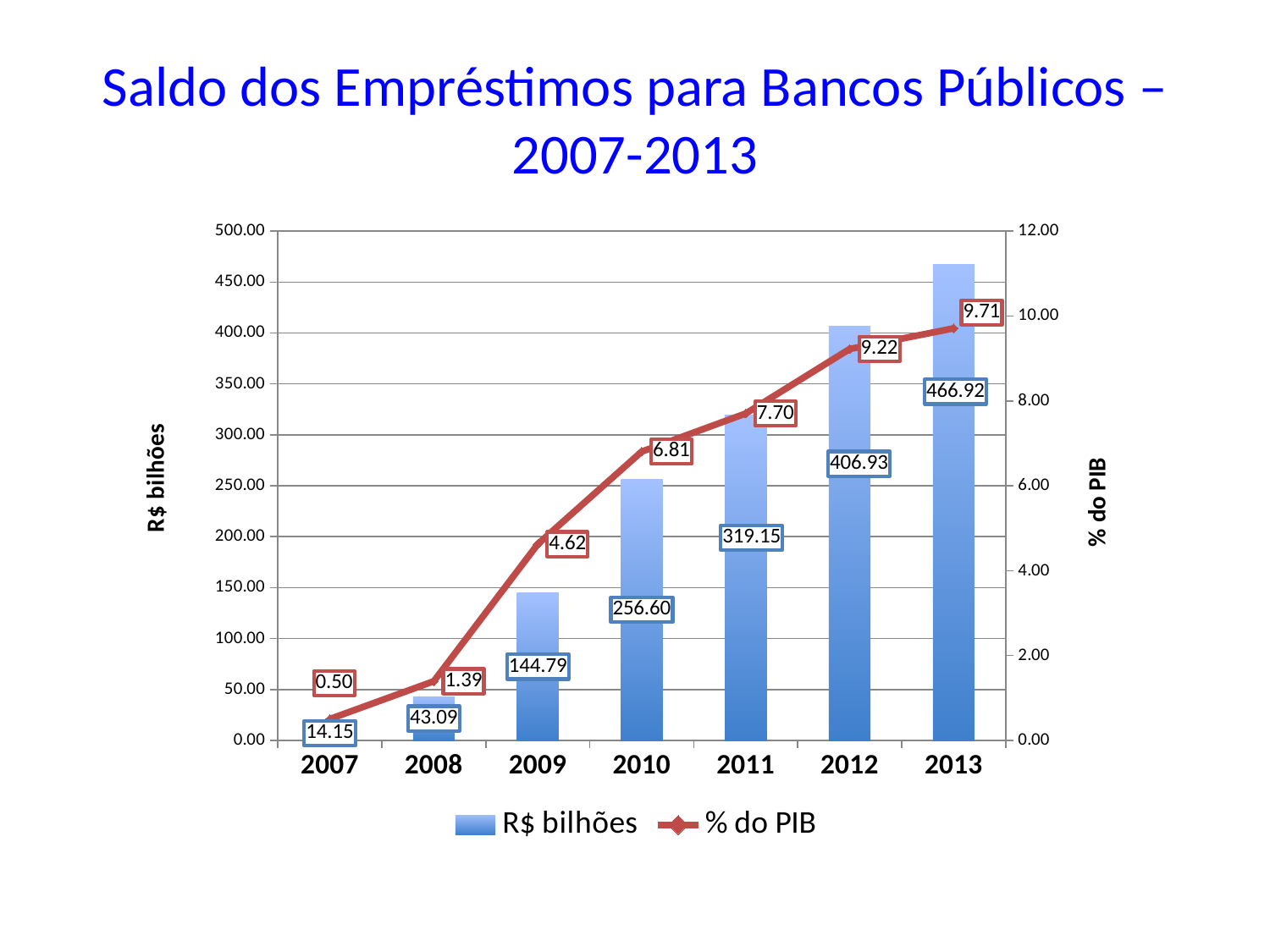
Which year has the highest % do PIB value? 2013 How many years are shown on the x axis? 7 What is the title of the chart? Saldo dos Empréstimos para Bancos Públicos – 2007-2013 Which is larger, the R$ bilhões value for 2009 or for 2010? 2010 What is the R$ bilhões value for 2013? 466.92 How many series does the legend list? 2 What is the R$ bilhões value for 2010? 256.60 Do the R$ bilhões values rise or fall from 2007 to 2013? rise What is the difference in % do PIB between 2013 and 2012? 0.49 What is the % do PIB value for 2009? 4.62 What is the difference in R$ bilhões between 2012 and 2011? 87.78 Which year has the lowest R$ bilhões value? 2007